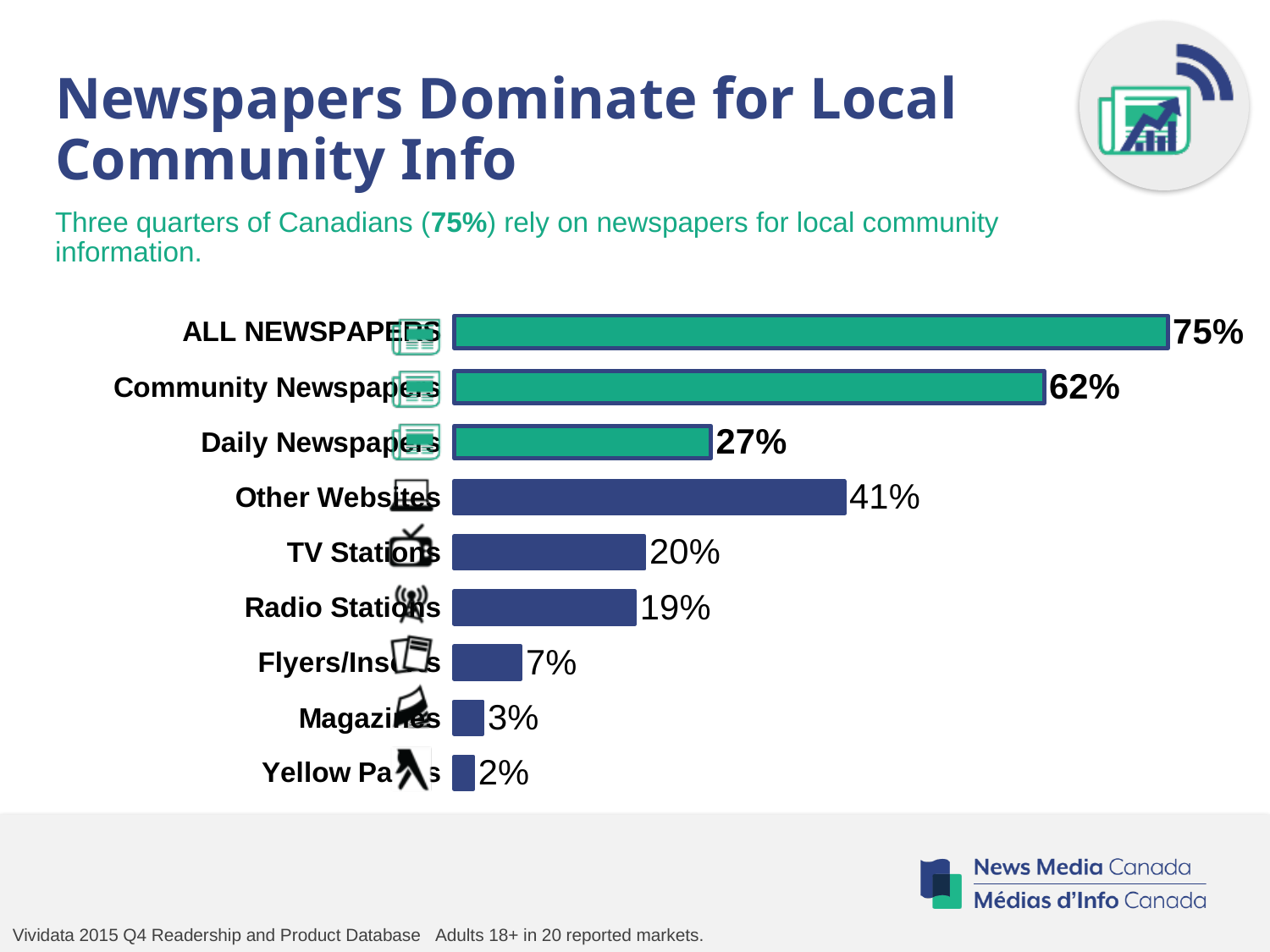
What colour are the bars for the newspaper categories? Green Which category has the highest value? ALL NEWSPAPERS What is the difference between the values for Other Websites and TV Stations? 21% What is the difference between the values for Community Newspapers and Daily Newspapers? 35% How many categories are shown in the chart? 9 What is the value for Radio Stations? 19% Which is larger, the value for Daily Newspapers or the value for Other Websites? Other Websites What kind of chart is shown on the slide? Bar chart What is the value for Flyers/Inserts? 7% What is the value for Other Websites? 41% Which category has the lowest value? Yellow Pages What is the value for Community Newspapers? 62%